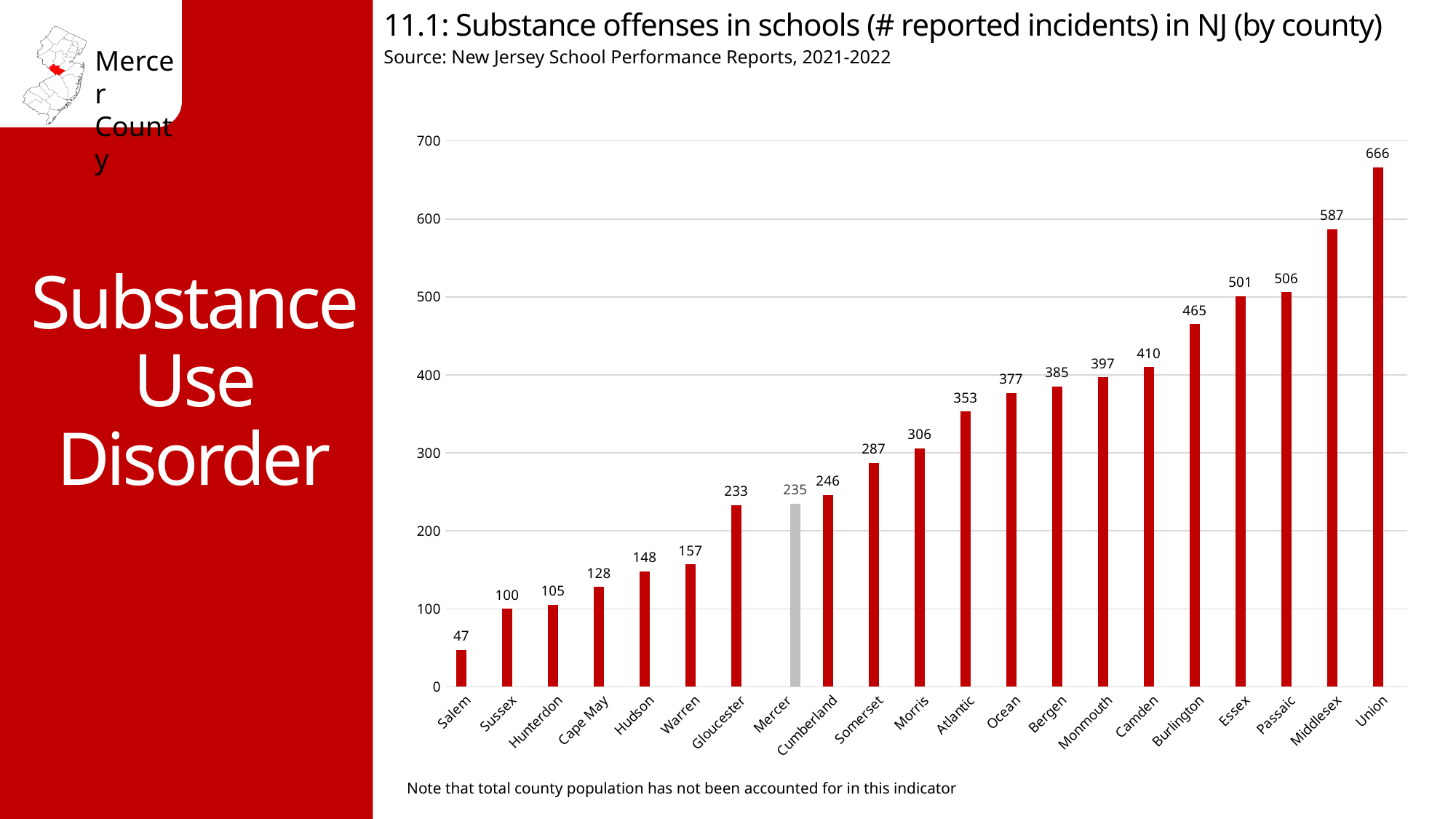
Is the value for Burlington greater or less than 500? less What kind of chart is shown on the slide? Bar chart What is the number of reported substance offense incidents in schools for Mercer County? 235 Which county has the lowest number of reported incidents? Salem Do the values rise or fall moving from left to right along the x axis? Rise What is the difference between the values for Mercer and Salem? 188 What is the value shown for Union County? 666 How many counties are shown on the chart? 21 What is the difference between the values for Union and Middlesex? 79 What is the value shown for Gloucester County? 233 Which has a larger value, Camden or Bergen? Camden Which county has the highest number of reported incidents? Union